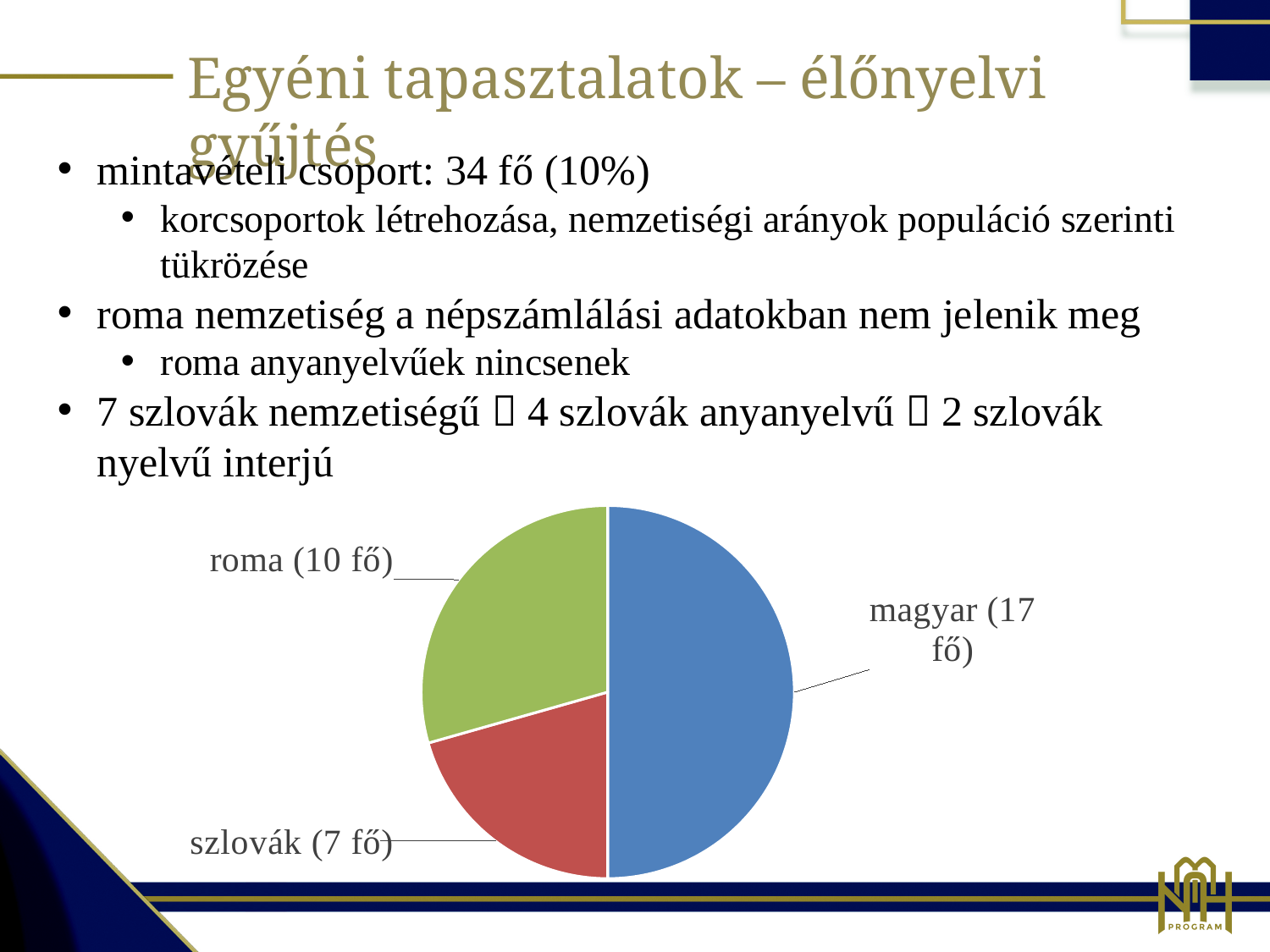
Which is larger, the roma slice or the szlovák slice? roma Which category has the smallest slice of the pie? szlovák What is the value shown for the szlovák slice? 7 fő What share of the pie does the magyar slice represent? 50% What is the value shown for the roma slice? 10 fő What is the value shown for the magyar slice? 17 fő What is the difference in number of people between the magyar and roma slices? 7 fő What kind of chart is shown on the slide? pie chart How many slices does the pie chart have? 3 What colour is the magyar slice of the pie? blue What is the difference in number of people between the roma and szlovák slices? 3 fő Which category has the largest slice of the pie? magyar